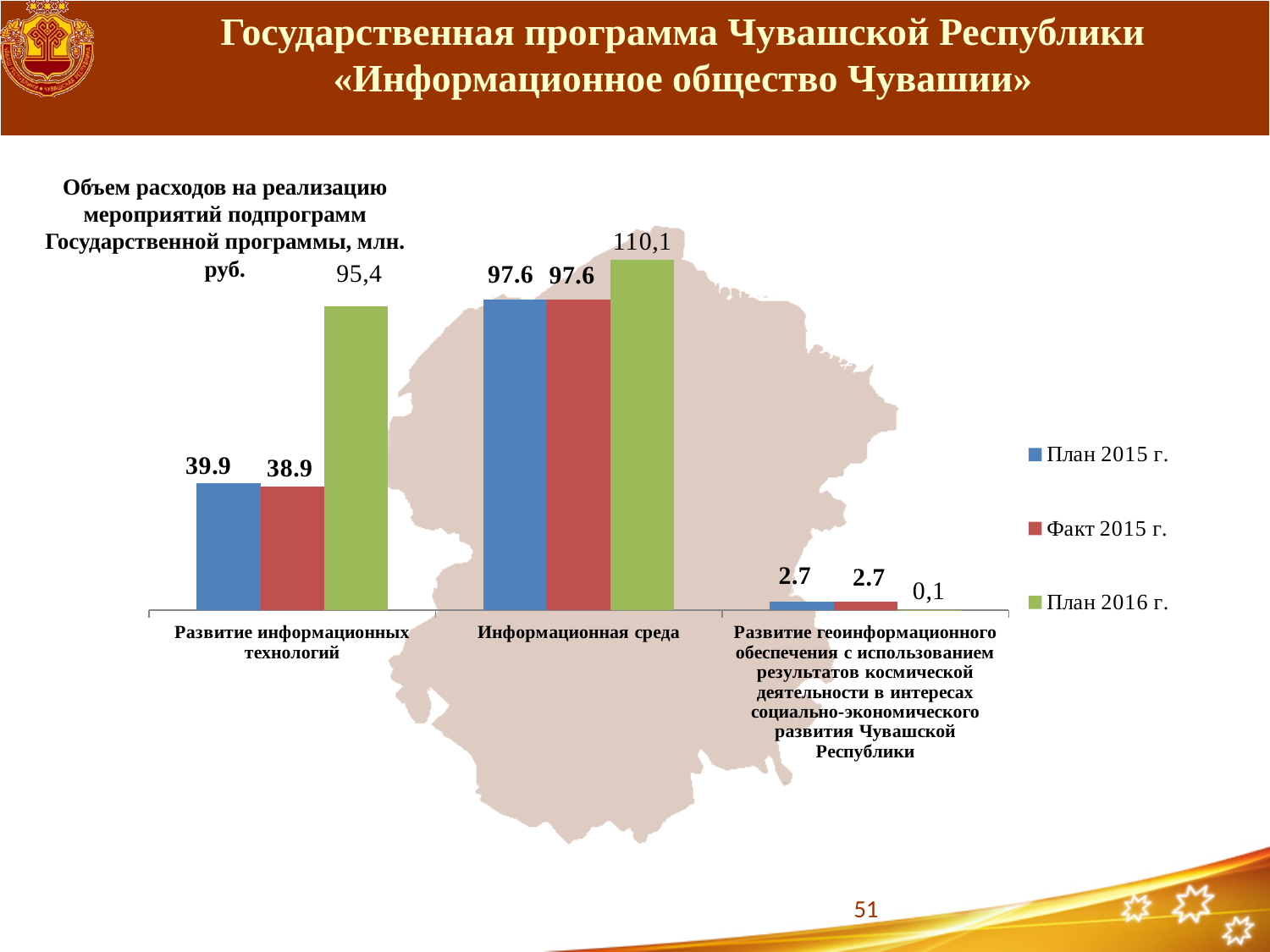
What kind of chart is shown on the slide? Bar chart How many categories are shown on the x axis of the chart? 3 What is the value for План 2016 г. in the category Развитие геоинформационного обеспечения с использованием результатов космической деятельности в интересах социально-экономического развития Чувашской Республики? 0,1 What is the value for План 2015 г. in the category Развитие информационных технологий? 39.9 What is the value for Факт 2015 г. in the category Развитие информационных технологий? 38.9 Which is larger for Информационная среда: План 2016 г. or Факт 2015 г.? План 2016 г. What is the difference between План 2016 г. and План 2015 г. for Развитие информационных технологий? 55.5 Which category has the lowest value for Факт 2015 г.? Развитие геоинформационного обеспечения с использованием результатов космической деятельности в интересах социально-экономического развития Чувашской Республики What is the value for План 2016 г. in the category Информационная среда? 110,1 Which category has the highest value for План 2016 г.? Информационная среда What colour represents Факт 2015 г. in the chart? Red How many series does the legend list? 3